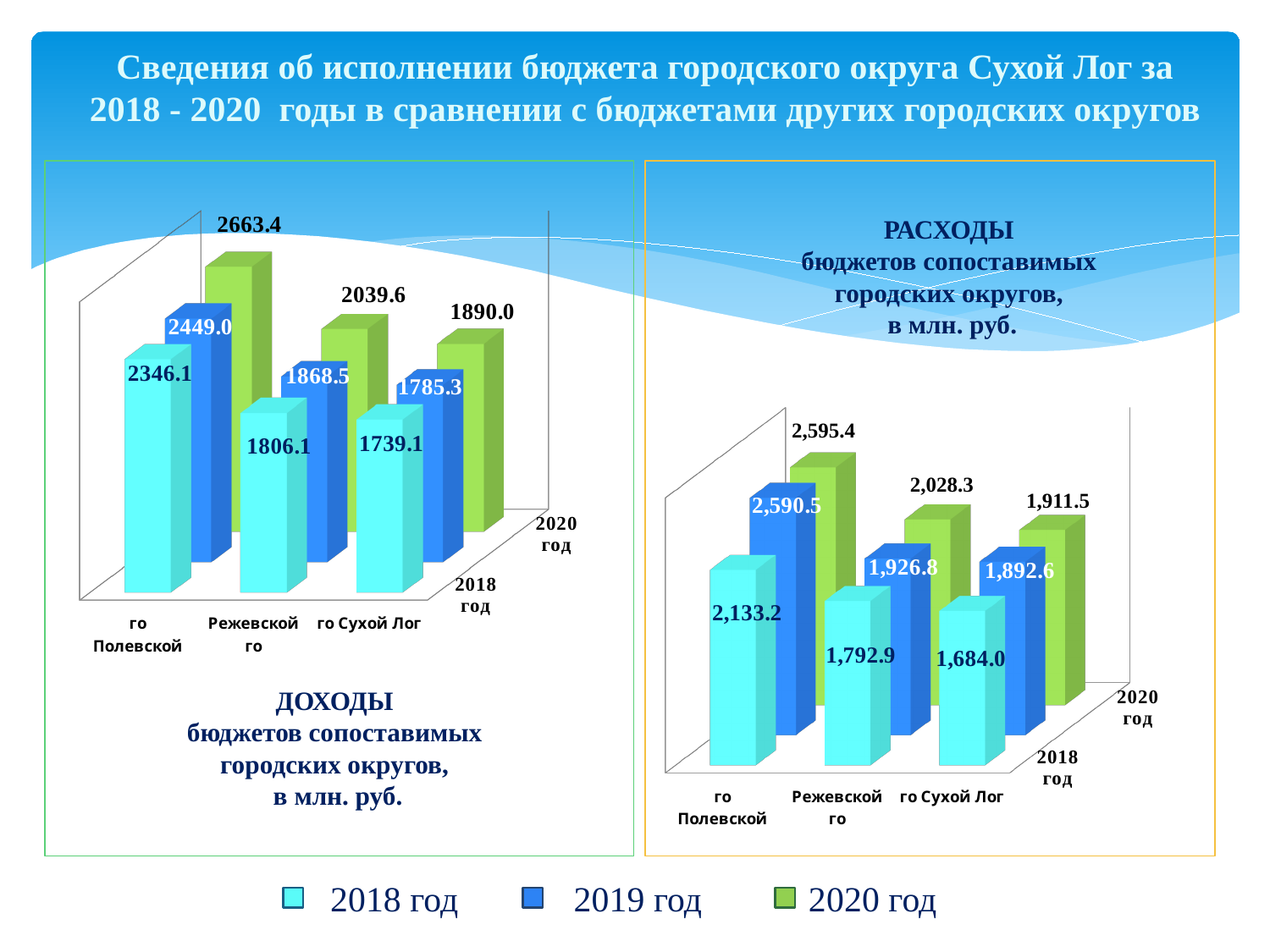
What kind of chart is the right chart (РАСХОДЫ)? Bar chart On the left chart (ДОХОДЫ), what is the difference between the 2020 год and 2018 год values for го Сухой Лог? 150.9 On the left chart (ДОХОДЫ), what is the value for го Полевской in 2020 год? 2663.4 On the right chart (РАСХОДЫ), what is the value for Режевской го in 2019 год? 1,926.8 How many series does the legend at the bottom of the slide list? 3 On the right chart (РАСХОДЫ), which city district has the lowest value in 2018 год? го Сухой Лог On the right chart (РАСХОДЫ), which is larger for го Полевской: the 2019 год value or the 2018 год value? 2019 год On the right chart (РАСХОДЫ), what is the value for го Сухой Лог in 2020 год? 1,911.5 On the left chart (ДОХОДЫ), do the values for Режевской го rise or fall from 2018 год to 2020 год? Rise How many city districts are shown on the left chart (ДОХОДЫ)? 3 On the left chart (ДОХОДЫ), what is the value for го Сухой Лог in 2018 год? 1739.1 On the left chart (ДОХОДЫ), which city district has the highest value in 2019 год? го Полевской